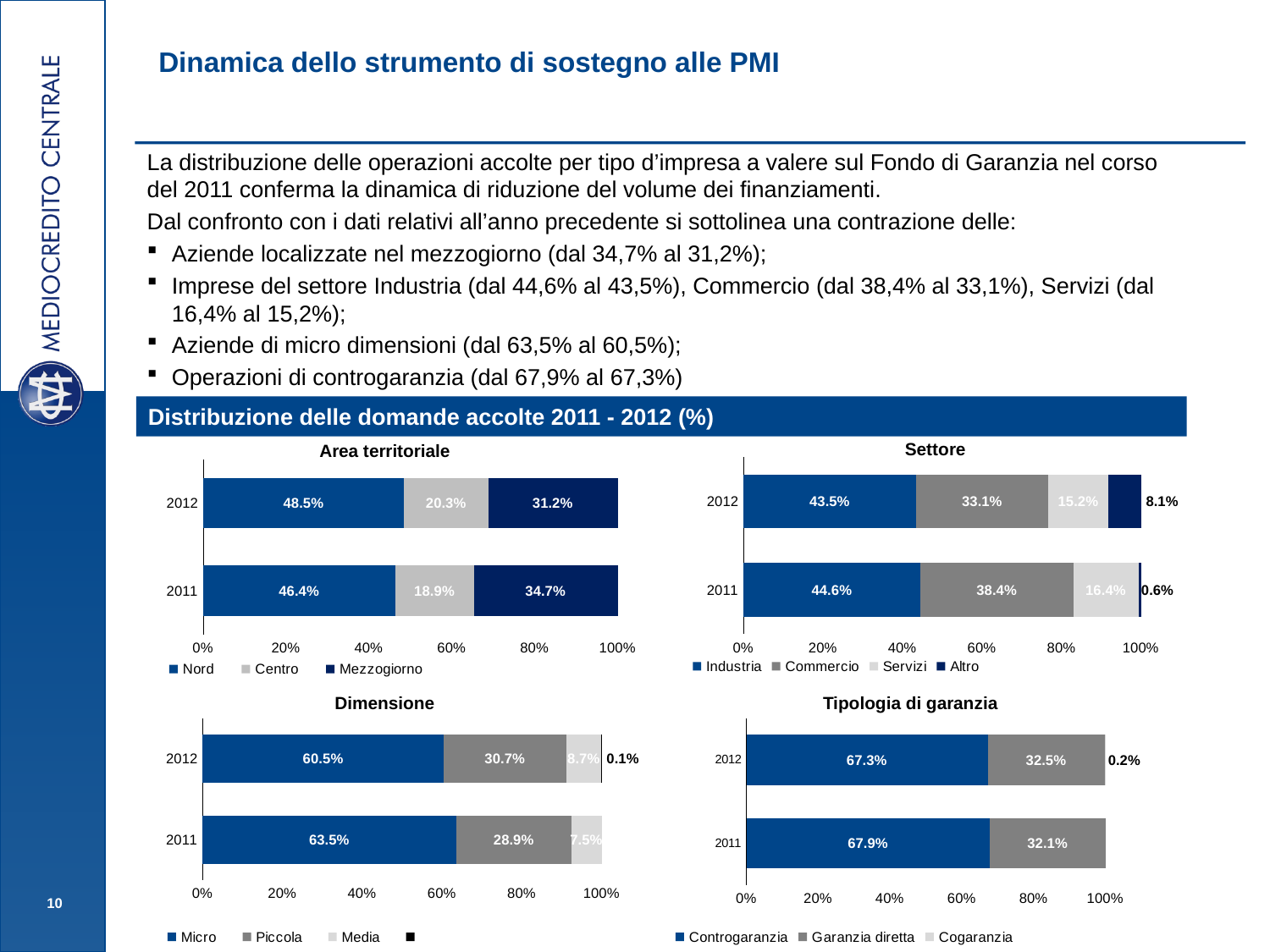
In the 'Settore' chart, what is the value for Altro in 2012? 8.1% In the 'Settore' chart, how many series does the legend list? 4 In the 'Dimensione' chart, is the Piccola share larger in 2012 or in 2011? 2012 In the 'Settore' chart, which sector has the largest share in 2012? Industria What kind of chart is the 'Area territoriale' chart? Stacked bar chart In the 'Settore' chart, what is the value for Commercio in 2011? 38.4% In the 'Tipologia di garanzia' chart, what is the value for Controgaranzia in 2012? 67.3% In the 'Area territoriale' chart, by how many percentage points did the Mezzogiorno share fall from 2011 to 2012? 3.5 percentage points In the 'Dimensione' chart, what is the value for Micro in 2011? 63.5% In the 'Area territoriale' chart, what is the value for Nord in 2012? 48.5% In the 'Area territoriale' chart, what is the value for Mezzogiorno in 2011? 34.7% In the 'Tipologia di garanzia' chart, what is the value for Garanzia diretta in 2011? 32.1%